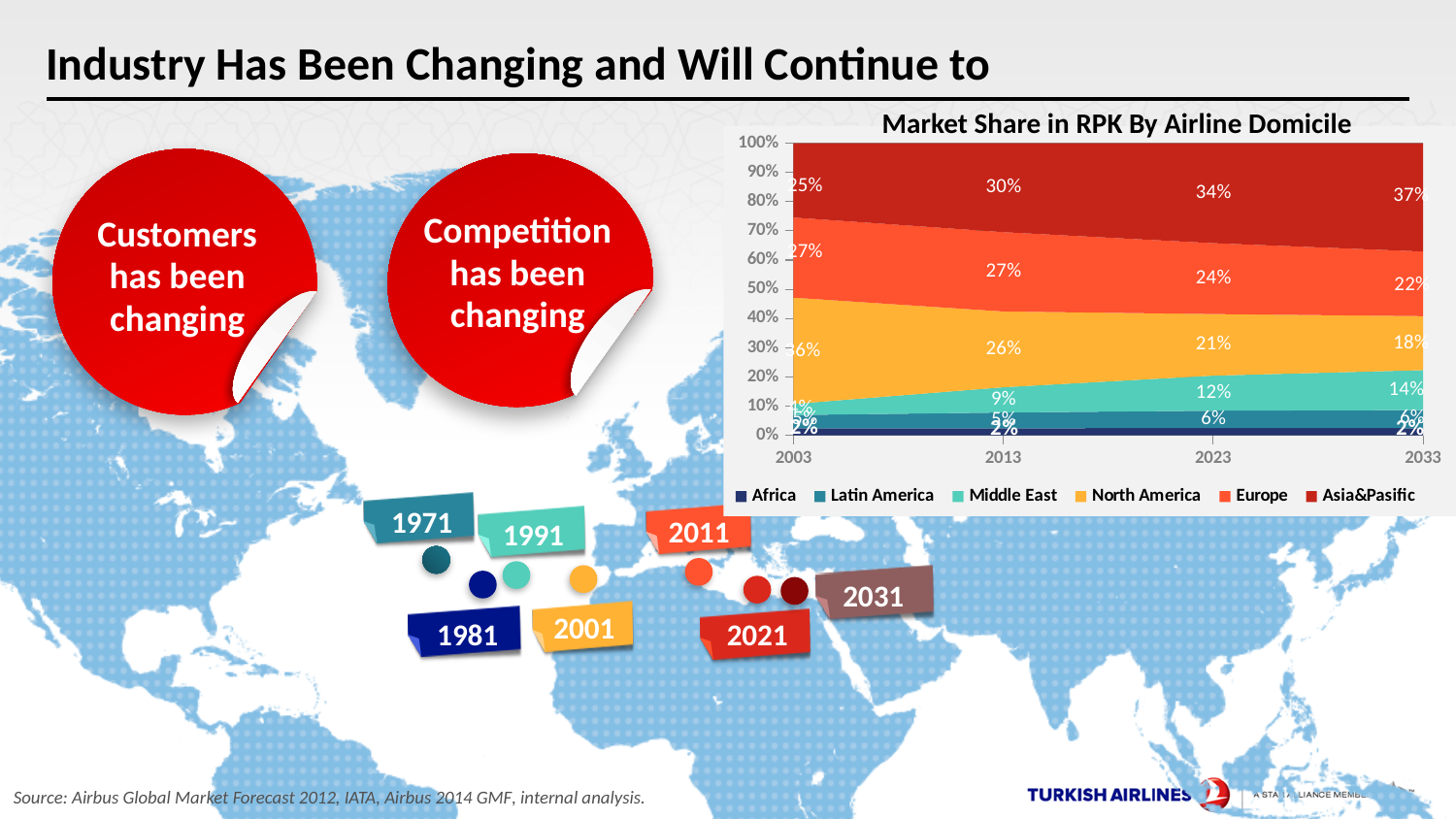
In 2023, which has the larger market share, Europe or North America? Europe How many series does the legend of the chart list? 6 What is the title of the chart? Market Share in RPK By Airline Domicile What kind of chart is shown on the slide? Area chart How many years are shown on the x axis of the chart? 4 Does the market share of North America rise or fall from 2003 to 2033? Fall What is the market share of Asia&Pasific in 2033? 37% What is the market share of Europe in 2033? 22% Does the market share of Asia&Pasific rise or fall from 2003 to 2033? Rise What is the market share of the Middle East in 2023? 12% What is the market share of North America in 2013? 26% By how many percentage points does the Asia&Pasific share in 2033 exceed its share in 2013? 7 percentage points